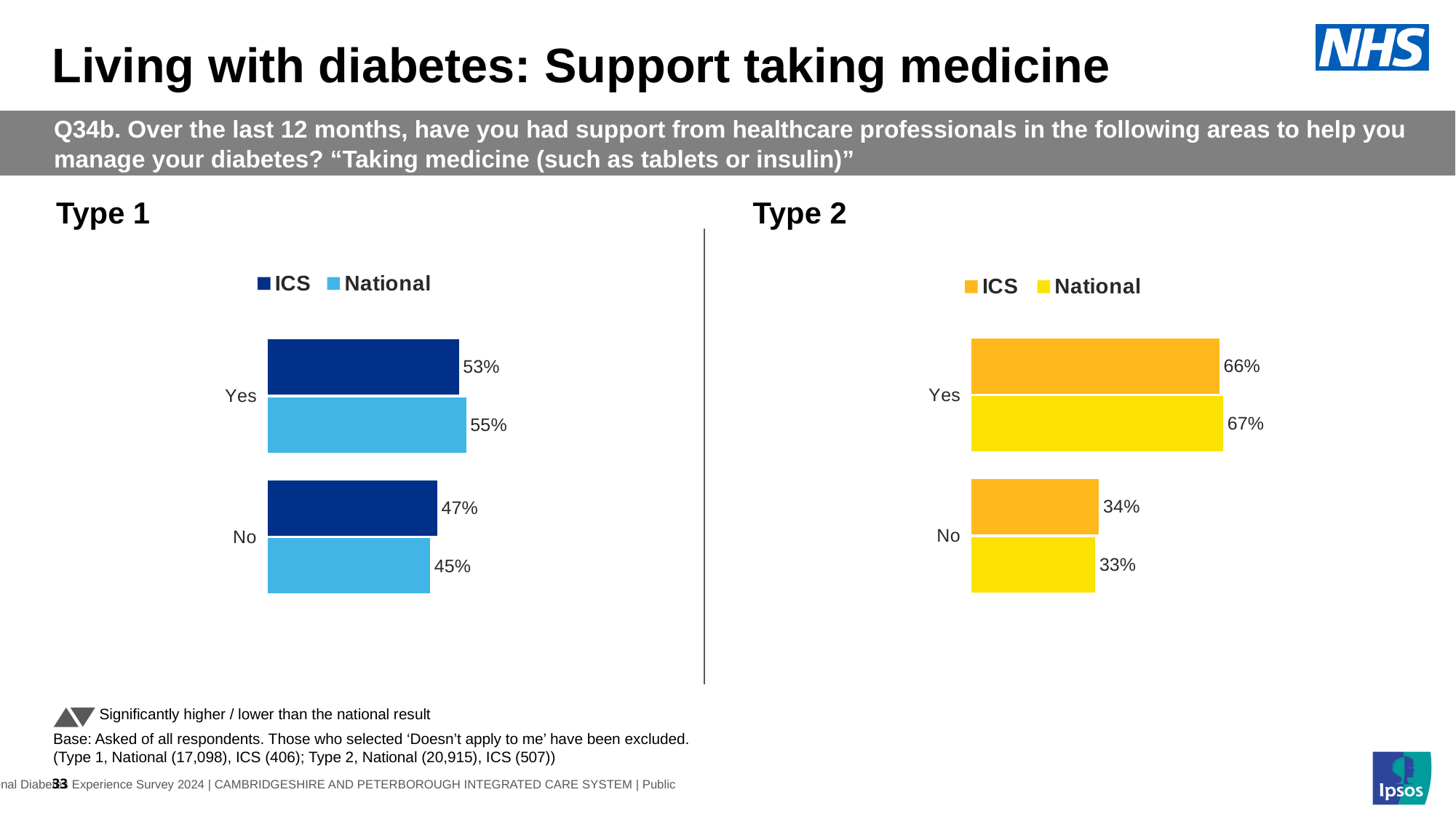
What kind of chart is the Type 1 chart? Bar chart In the Type 2 chart, what is the ICS value for Yes? 66% In the Type 2 chart, what is the difference between the ICS values for Yes and No? 32 percentage points In the Type 1 chart, what is the difference between the National and ICS values for Yes? 2 percentage points In the Type 2 chart, which category has the highest National value? Yes How many categories are shown in the Type 2 chart? 2 In the Type 1 chart, what is the National value for No? 45% In the Type 1 chart, which category has the lowest ICS value? No How many series does the legend of the Type 2 chart list? 2 In the Type 2 chart, what is the National value for No? 33% In the Type 1 chart, which is larger for No: ICS or National? ICS In the Type 1 chart, what is the ICS value for Yes? 53%